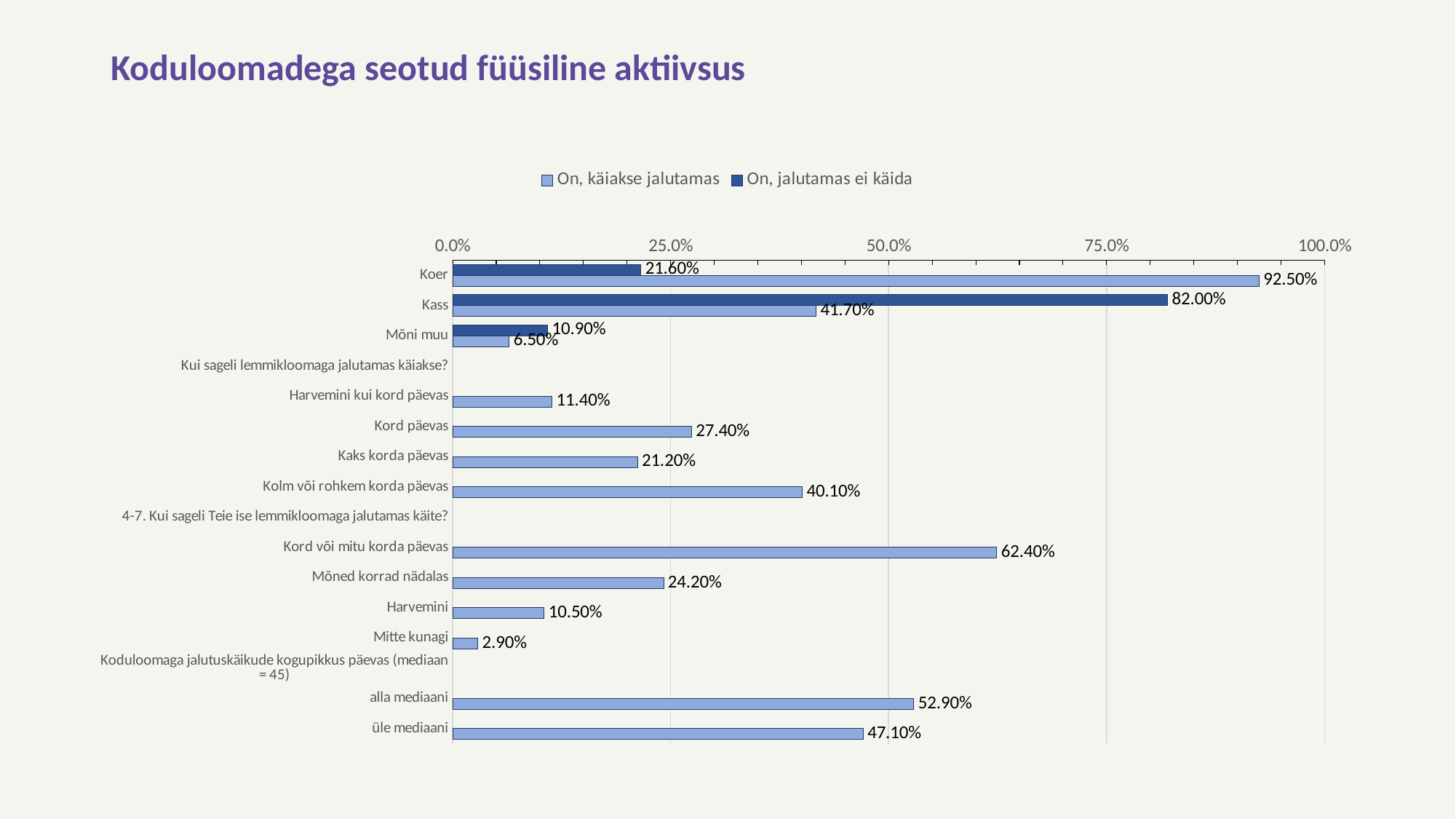
What is the value for Koer in the "On, käiakse jalutamas" series? 92.50% What is the difference between the "On, käiakse jalutamas" values for Koer and Kass? 50.80% How many series does the legend list? 2 What is the value for Kass in the "On, jalutamas ei käida" series? 82.00% What is the value for Mitte kunagi? 2.90% Which category has the highest value in the "On, käiakse jalutamas" series? Koer What is the value for Kolm või rohkem korda päevas? 40.10% Which is larger: the value for Kord päevas or the value for Kaks korda päevas? Kord päevas What kind of chart is shown on the slide? bar chart What is the title of the chart on the slide? Koduloomadega seotud füüsiline aktiivsus Is the value for Kord või mitu korda päevas greater or less than 50.0%? greater Which category has the lowest value in the "On, jalutamas ei käida" series? Mõni muu